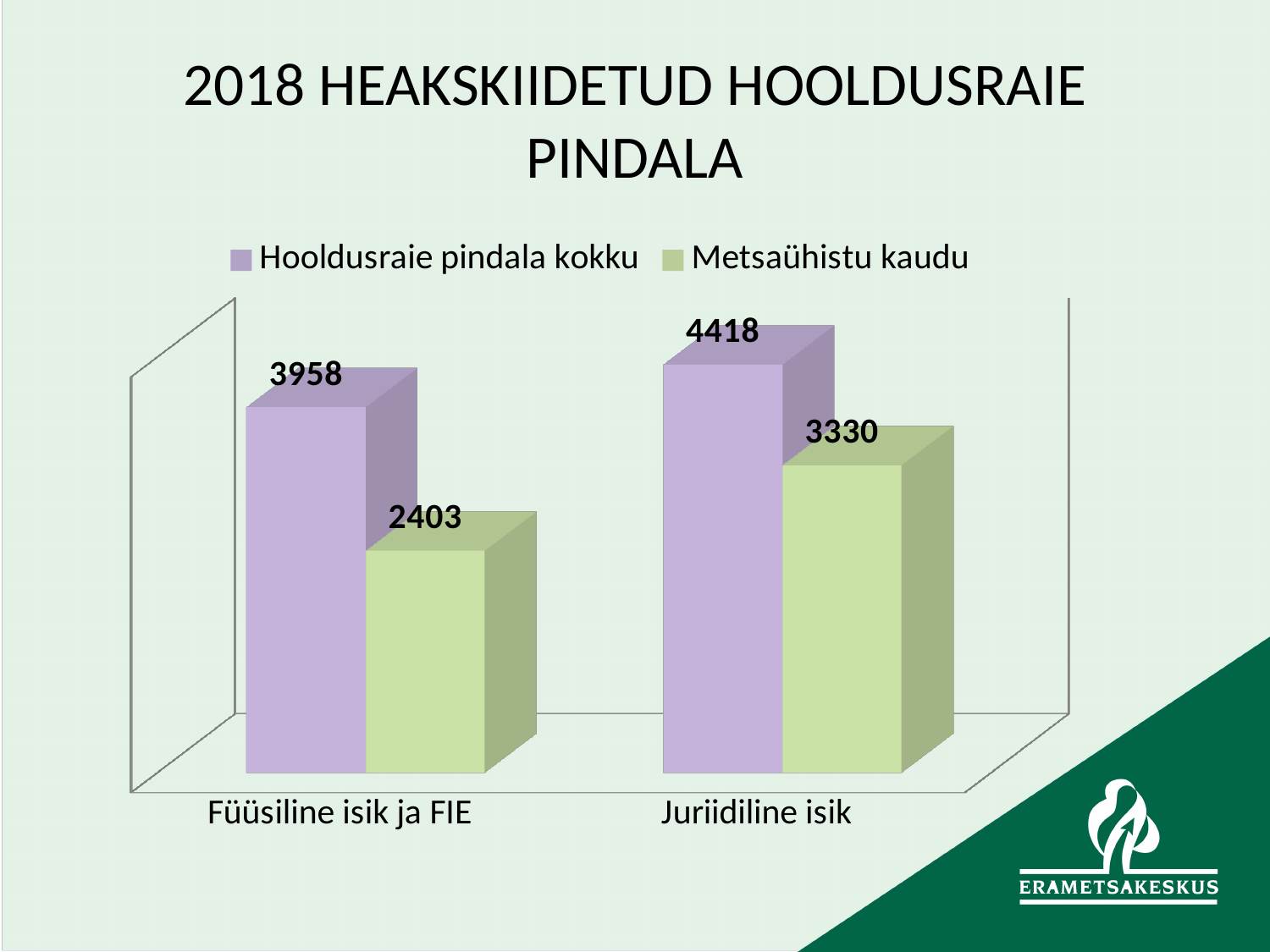
Which category has the lowest Metsaühistu kaudu value? Füüsiline isik ja FIE How many series does the legend list? 2 What is the difference between Hooldusraie pindala kokku and Metsaühistu kaudu for Füüsiline isik ja FIE? 1555 What is the difference between Hooldusraie pindala kokku and Metsaühistu kaudu for Juriidiline isik? 1088 What kind of chart is shown on the slide? Bar chart Which is larger: Metsaühistu kaudu for Juriidiline isik or Hooldusraie pindala kokku for Füüsiline isik ja FIE? Hooldusraie pindala kokku for Füüsiline isik ja FIE What is the value of Hooldusraie pindala kokku for Füüsiline isik ja FIE? 3958 How many categories are shown on the x axis? 2 What is the value of Metsaühistu kaudu for Füüsiline isik ja FIE? 2403 What is the value of Hooldusraie pindala kokku for Juriidiline isik? 4418 What is the value of Metsaühistu kaudu for Juriidiline isik? 3330 Which category has the highest Hooldusraie pindala kokku value? Juriidiline isik